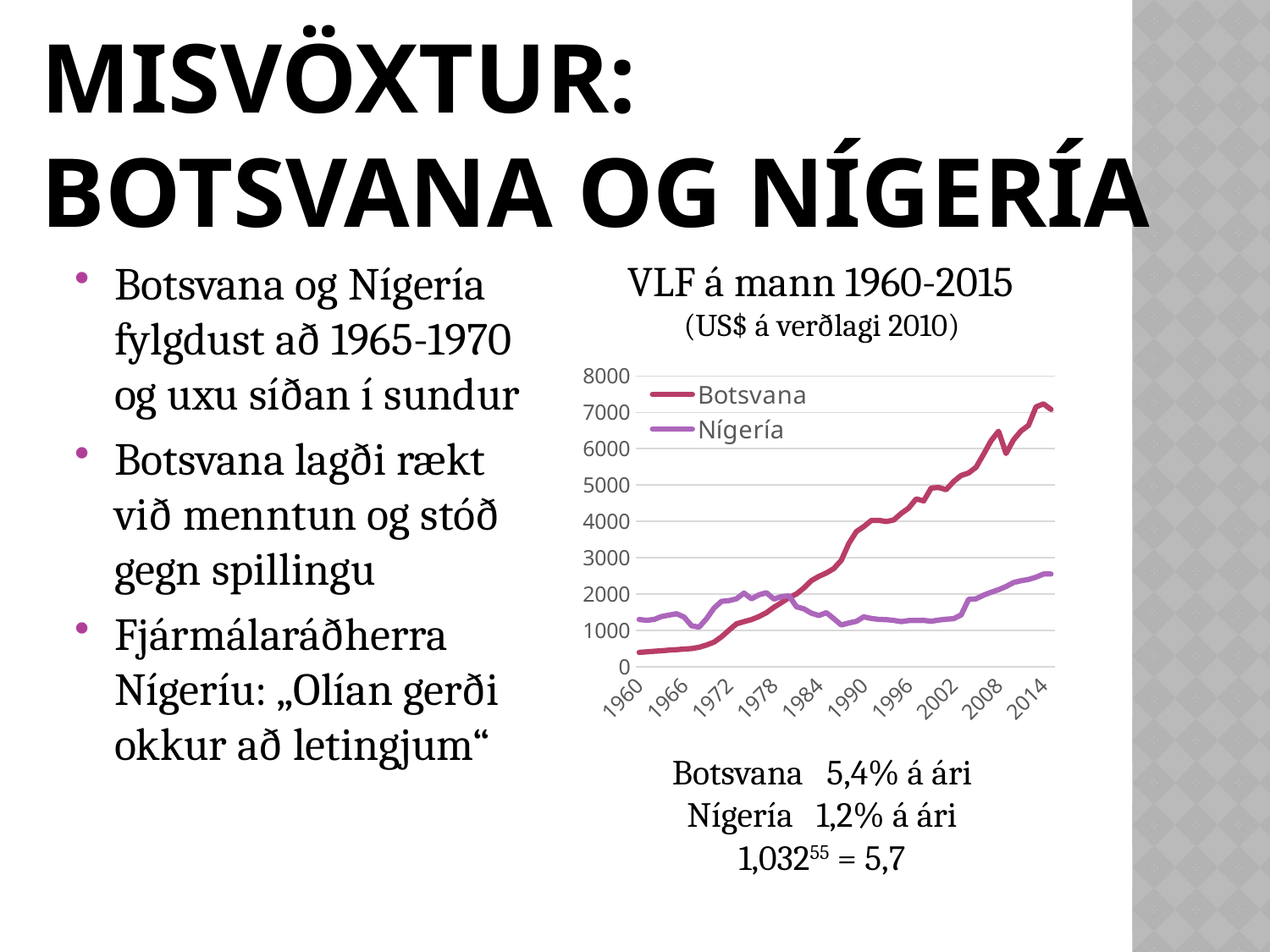
Is the value for Botsvana in 1990 greater or less than 3000? greater Does the Botsvana line generally rise or fall from 1960 to 2015? rise In 1960, which series has the larger value, Botsvana or Nígería? Nígería In 2014, which series has the larger value, Botsvana or Nígería? Botsvana What kind of chart is shown on the slide? line chart Is the value for Botsvana in 1960 greater or less than 1000? less Is the value for Botsvana in 2014 greater or less than 6000? greater Which series reaches the highest value on the chart? Botsvana How many series does the chart's legend list? 2 What is the title of the chart? VLF á mann 1960-2015 Which two series are listed in the chart's legend? Botsvana and Nígería